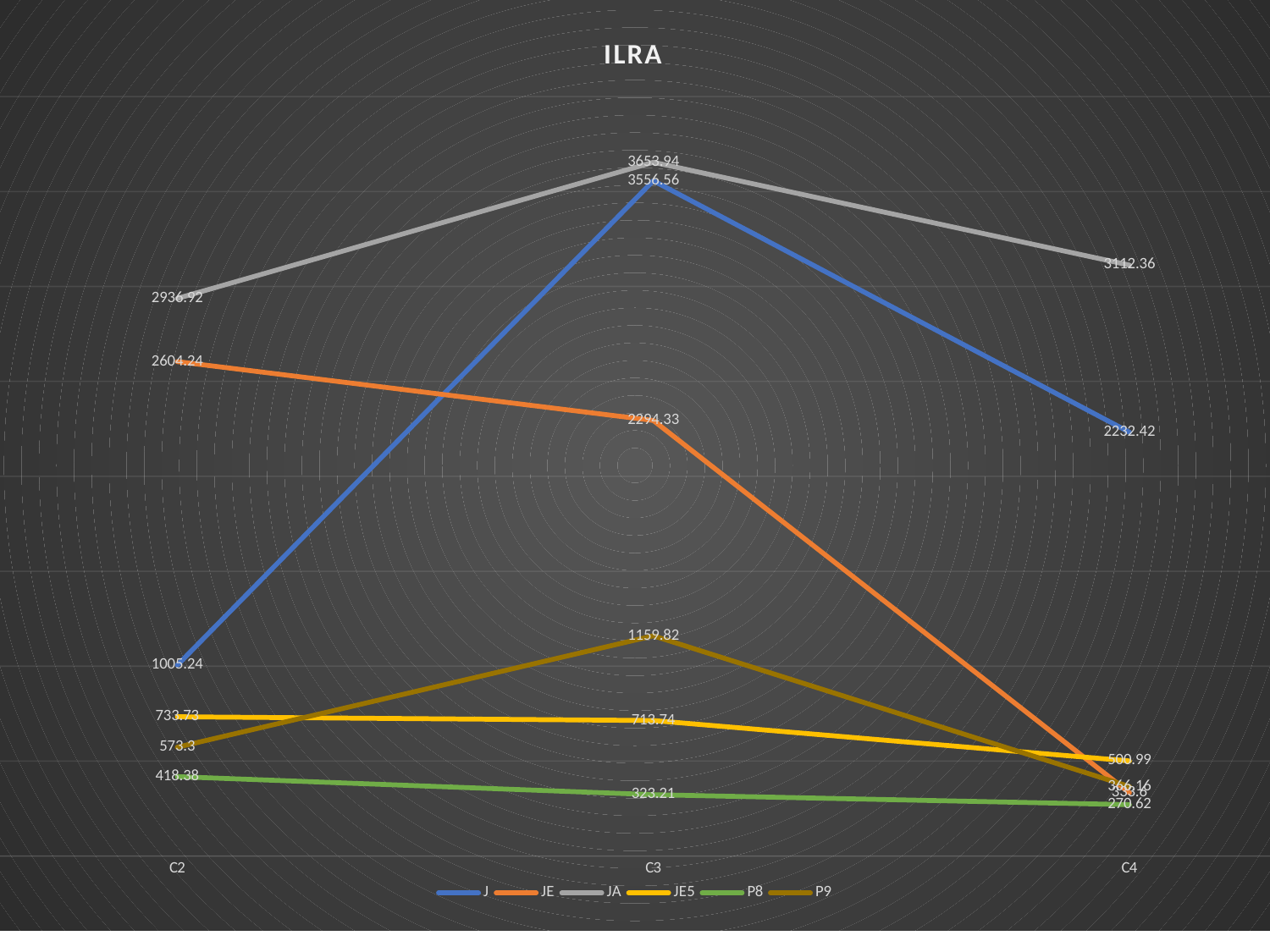
What is the value of the P8 series at C4? 270.62 How many series does the legend list? 6 At C2, which series has the larger value, JA or JE? JA How many categories are shown on the x axis? 3 Which series has the lowest value at C3? P8 What is the value of the J series at C2? 1005.24 Does the P8 series rise or fall from C2 to C4? fall What is the difference between the J series values at C3 and C4? 1324.14 What is the value of the JA series at C3? 3653.94 What kind of chart is shown on the slide? line chart At which category does the JA series reach its highest value? C3 What is the value of the P9 series at C3? 1159.82